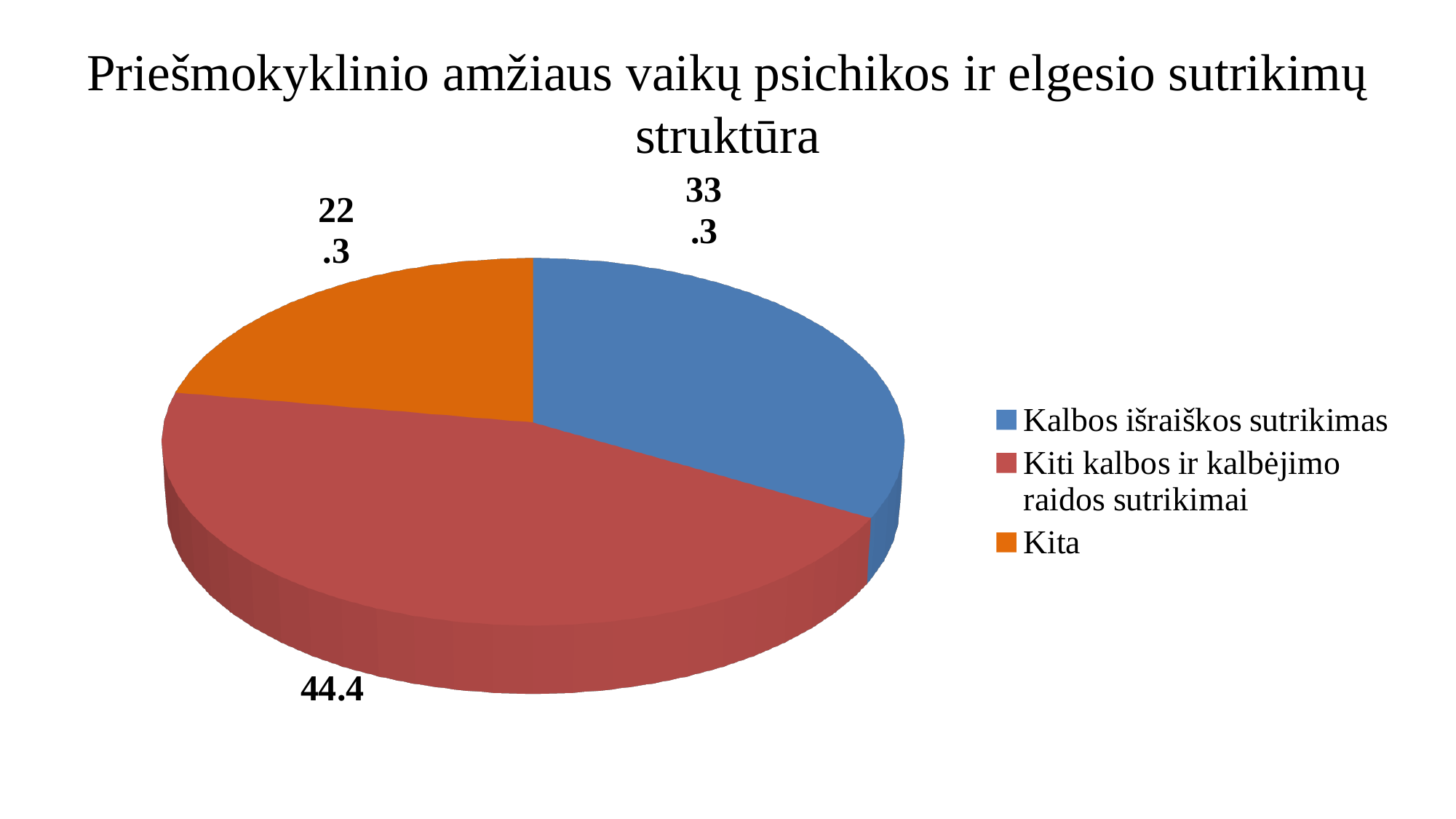
Which colour represents Kita in the pie chart? orange What is the title of the chart? Priešmokyklinio amžiaus vaikų psichikos ir elgesio sutrikimų struktūra What type of chart is shown on the slide? pie chart Which category has the smallest slice of the pie? Kita What is the value for Kalbos išraiškos sutrikimas? 33.3 What is the value for Kita? 22.3 Which is larger, the value for Kalbos išraiškos sutrikimas or the value for Kita? Kalbos išraiškos sutrikimas What is the value for Kiti kalbos ir kalbėjimo raidos sutrikimai? 44.4 How many slices does the pie chart have? 3 What is the difference between the values for Kiti kalbos ir kalbėjimo raidos sutrikimai and Kalbos išraiškos sutrikimas? 11.1 Which category has the largest slice of the pie? Kiti kalbos ir kalbėjimo raidos sutrikimai What is the difference between the values for Kalbos išraiškos sutrikimas and Kita? 11